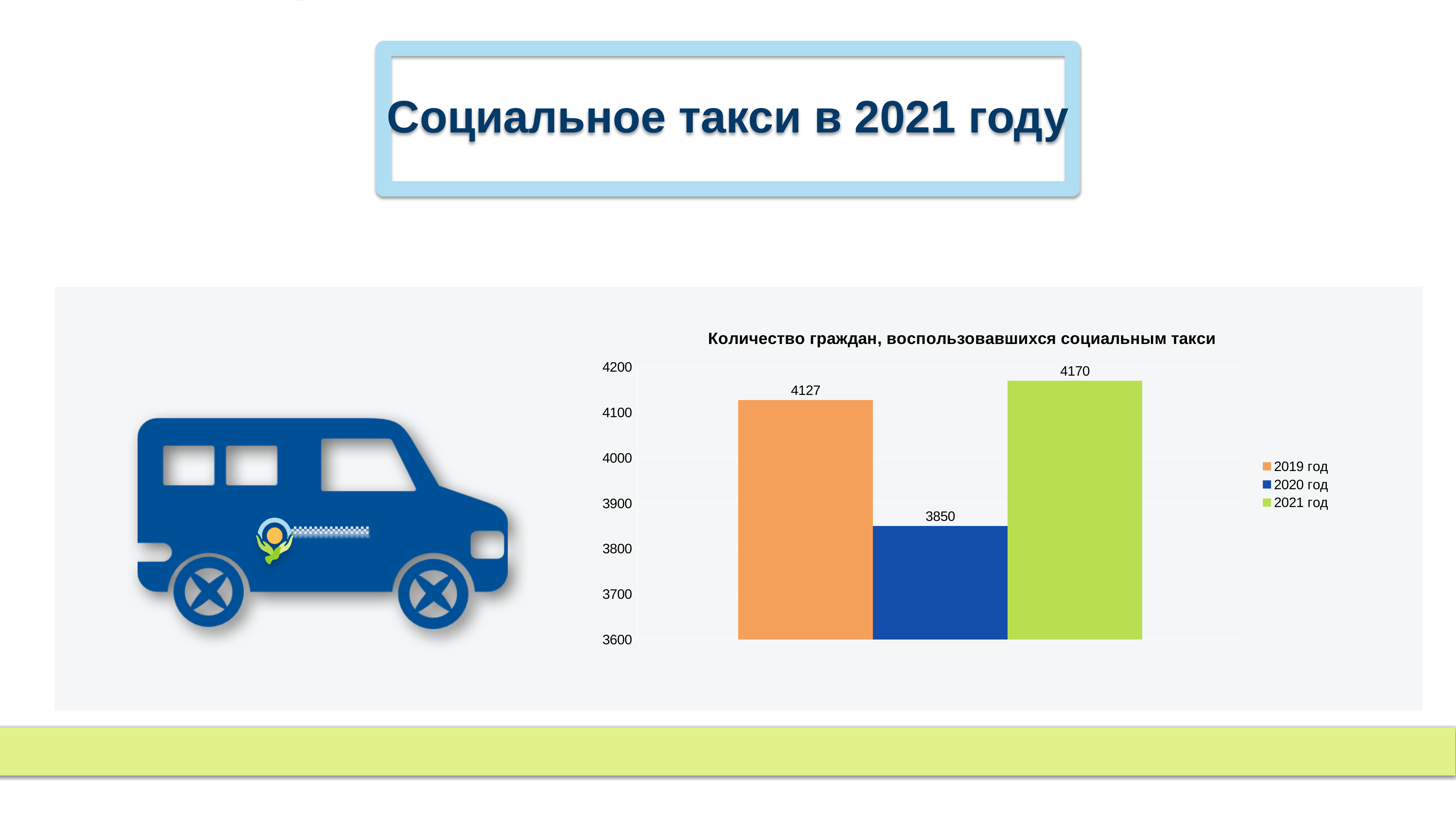
Which year has the highest value? 2021 год Which is larger, the value for 2019 год or the value for 2020 год? 2019 год What is the difference between the values for 2021 год and 2019 год? 43 What is the value for 2020 год? 3850 How many series does the legend list? 3 What is the value for 2019 год? 4127 What is the difference between the values for 2021 год and 2020 год? 320 What is the title of the chart? Количество граждан, воспользовавшихся социальным такси Is the value for 2020 год greater or less than 3900? less What is the value for 2021 год? 4170 What kind of chart is shown on the slide? bar chart Which year has the lowest value? 2020 год